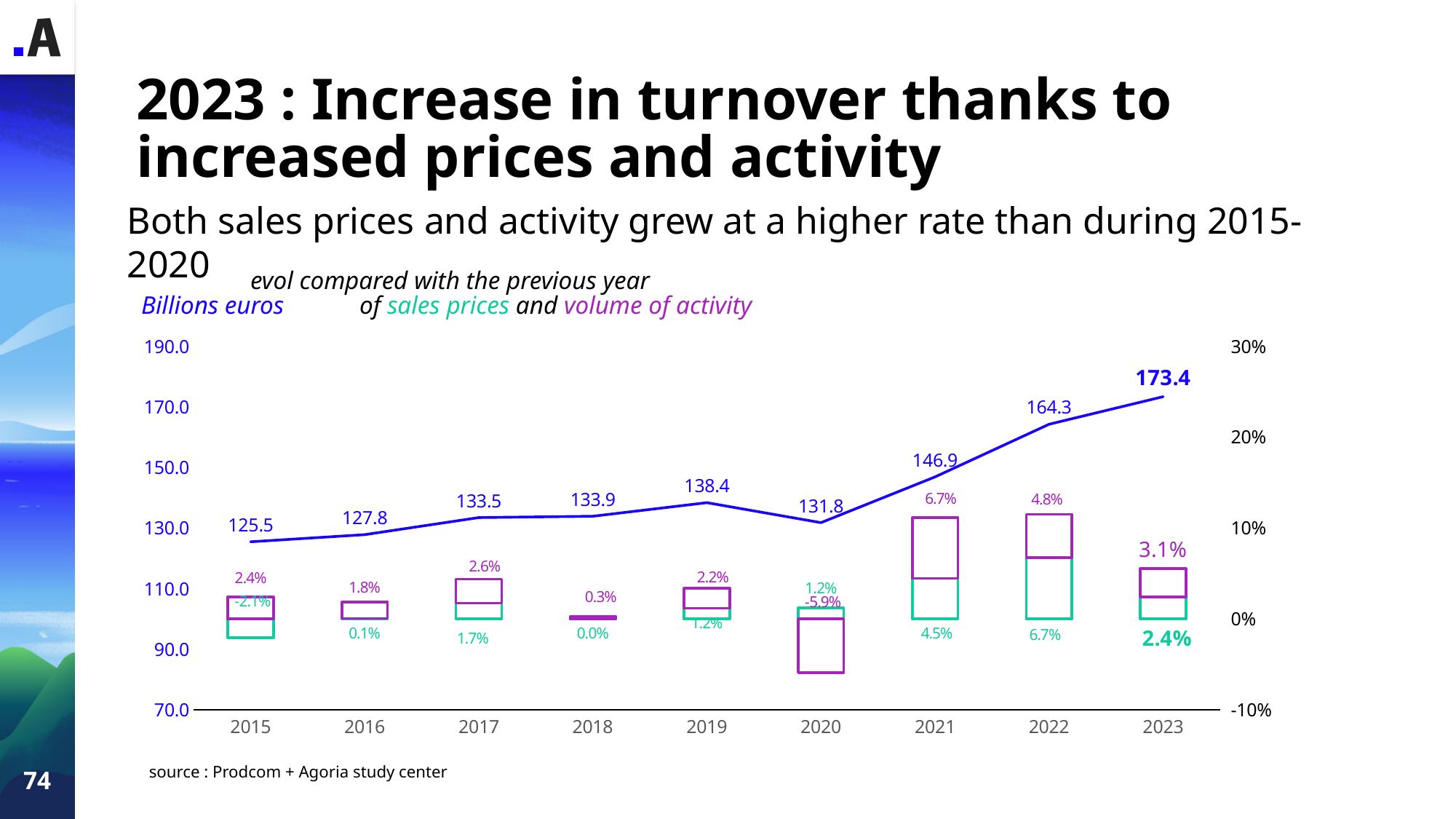
Which year had a higher turnover, 2019 or 2020? 2019 What was the evolution of volume of activity in 2021? 6.7% Did turnover in billions euros rise or fall between 2020 and 2023? rise By how much did turnover (billions euros) increase from 2022 to 2023? 9.1 In which year was the evolution of volume of activity the lowest? 2020 How many years are shown on the x axis? 9 In which year was the evolution of sales prices the highest? 2022 In which year was the turnover (billions euros) the lowest? 2015 What colour is used for the sales prices series? green What was the turnover in billions euros in 2020? 131.8 What was the turnover in billions euros in 2023? 173.4 What was the evolution of sales prices in 2023? 2.4%